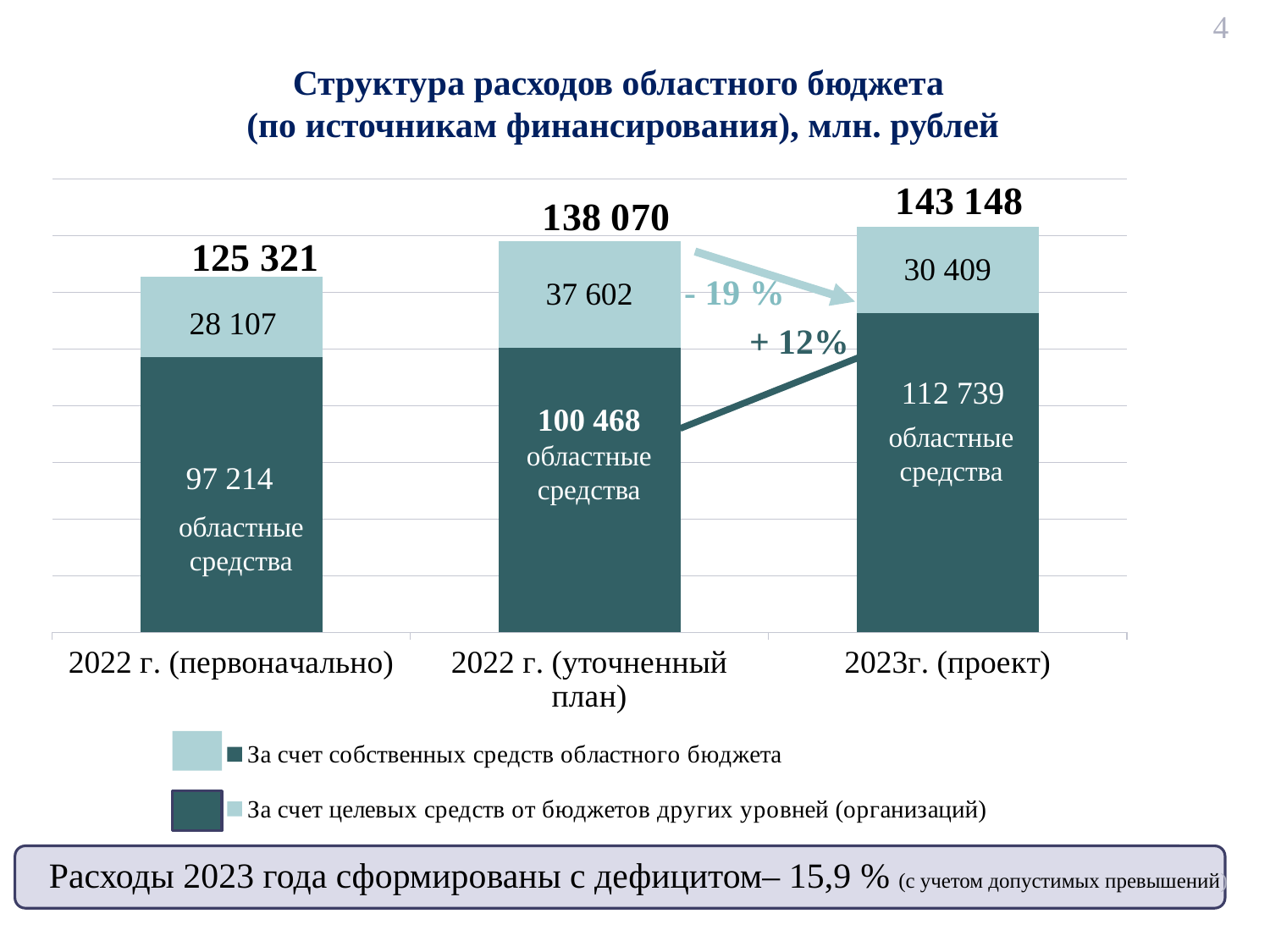
Which category has the highest total value? 2023г. (проект) What is the value of the upper (light) segment for 2022 г. (уточненный план)? 37 602 What is the total value of the bar for 2022 г. (уточненный план)? 138 070 What is the difference between the 'областные средства' values for 2023г. (проект) and 2022 г. (уточненный план)? 12 271 What type of chart is shown on the slide? stacked bar chart What is the value of the 'областные средства' segment for 2022 г. (первоначально)? 97 214 How many categories (bars) are shown on the x axis? 3 Do the bar totals rise or fall from left to right along the x axis? rise What is the total value of the bar for 2023г. (проект)? 143 148 What is the total value of the bar for 2022 г. (первоначально)? 125 321 How many series does the legend list? 2 What is the value of the 'областные средства' segment for 2023г. (проект)? 112 739